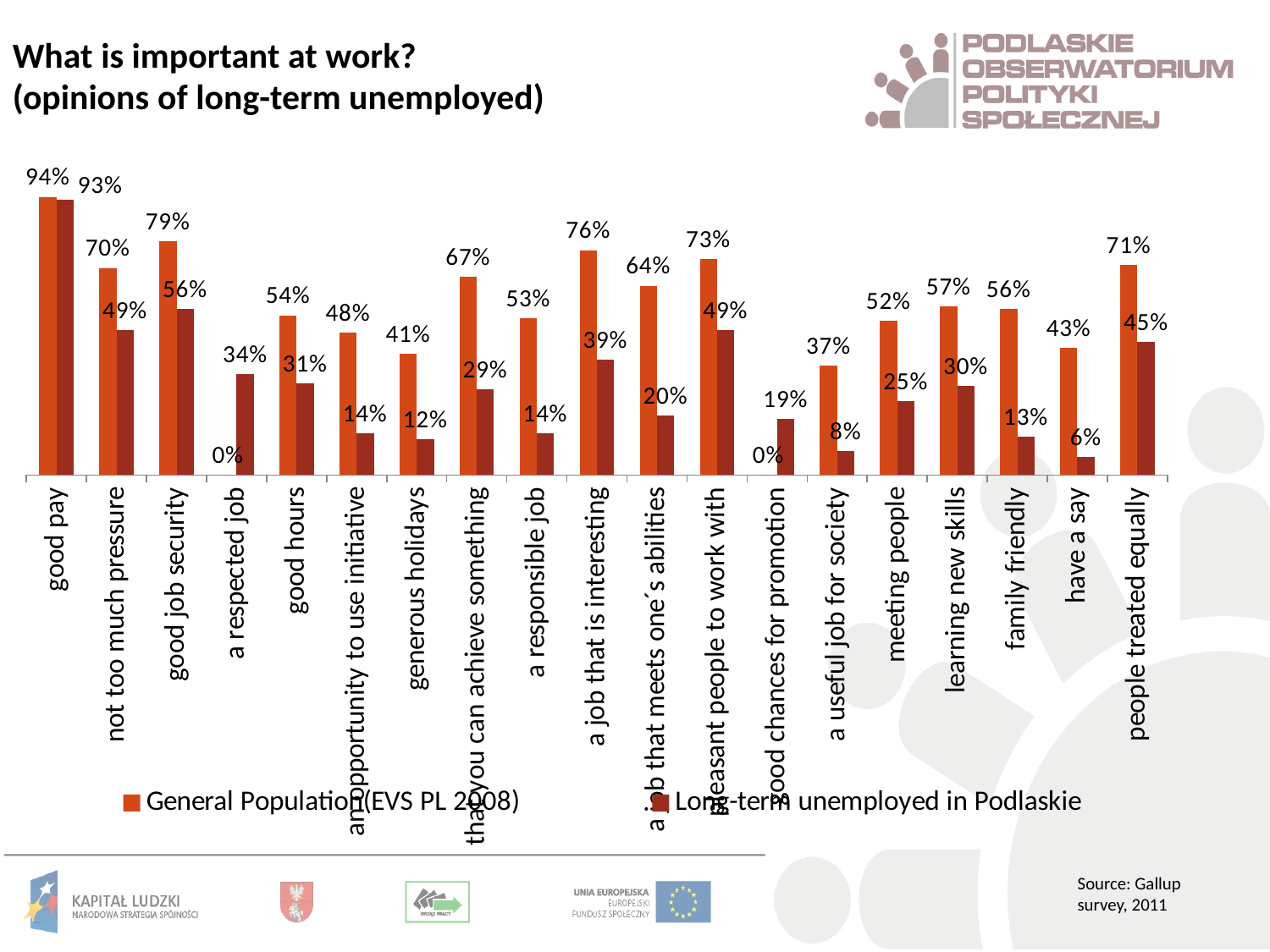
What is the value for 'people treated equally' in the General Population (EVS PL 2008) series? 71% What is the difference between the General Population and Long-term unemployed values for 'not too much pressure'? 21 percentage points What is the value for 'good job security' in the Long-term unemployed in Podlaskie series? 56% How many series does the legend list? 2 What kind of chart is shown on the slide? bar chart Which is larger for 'pleasant people to work with': the General Population value or the Long-term unemployed value? General Population (EVS PL 2008) Which category has the lowest value in the Long-term unemployed in Podlaskie series? have a say What is the value for 'a respected job' in the Long-term unemployed in Podlaskie series? 34% What is the value for 'have a say' in the Long-term unemployed in Podlaskie series? 6% How many categories are shown on the x axis? 19 What is the value for 'good pay' in the General Population (EVS PL 2008) series? 94% Which category has the highest value in the General Population (EVS PL 2008) series? good pay